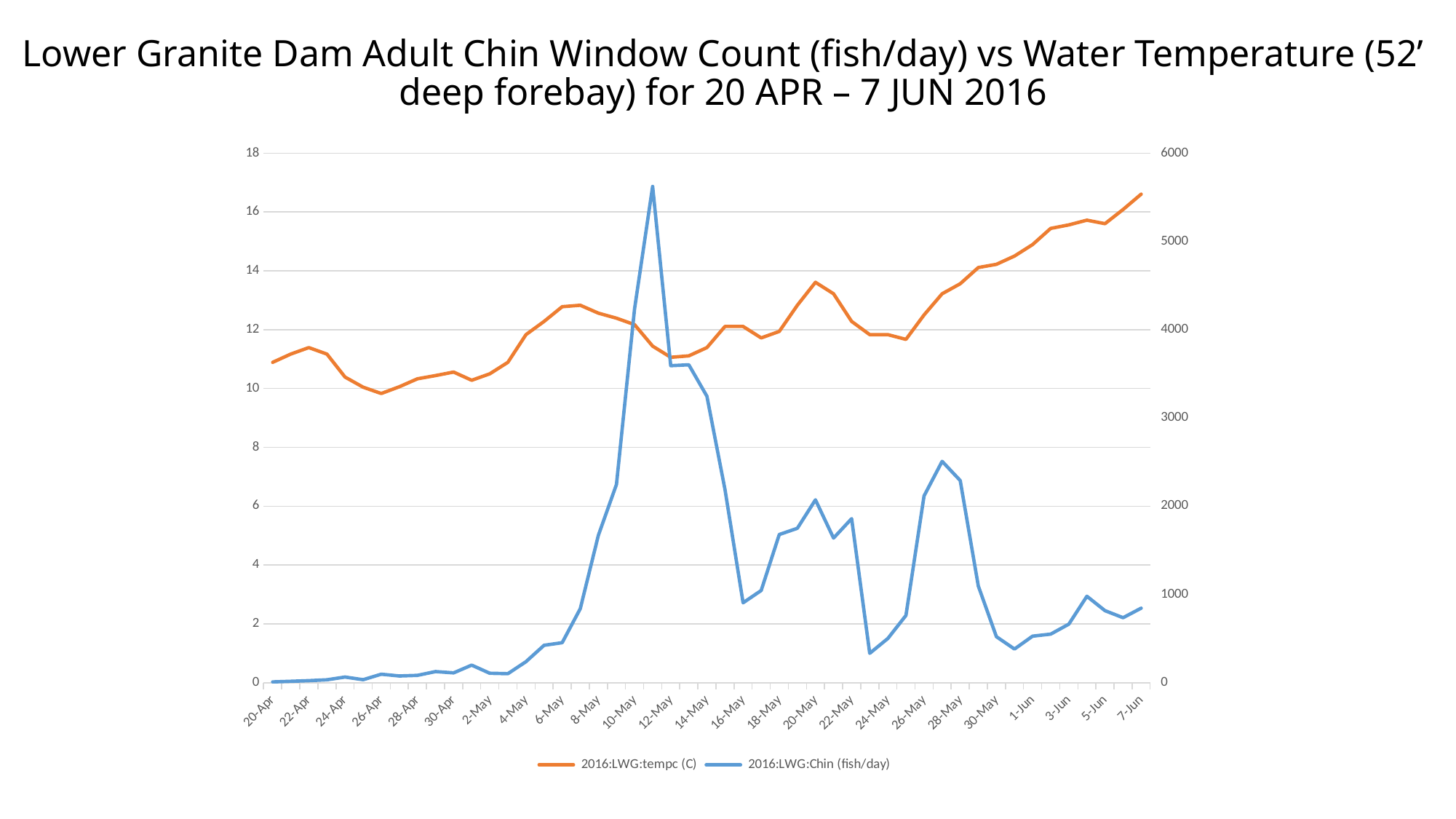
Which colour is used for the 2016:LWG:Chin (fish/day) series? Blue Is the peak value of the 2016:LWG:Chin (fish/day) series greater or less than 5000? greater Overall, does the water temperature rise or fall from 20-Apr to 7-Jun? Rise How many series does the legend list? 2 On which labeled date is the water temperature (2016:LWG:tempc) highest? 7-Jun On which labeled date is the water temperature (2016:LWG:tempc) lowest? 26-Apr Is the Chin count (fish/day) on 28-May greater or less than 2000? greater Is the water temperature on 7-Jun greater or less than 16? greater Which is larger, the water temperature on 20-Apr or on 7-Jun? 7-Jun What are the two series named in the legend? 2016:LWG:tempc (C) and 2016:LWG:Chin (fish/day) What kind of chart is shown on the slide? Line chart